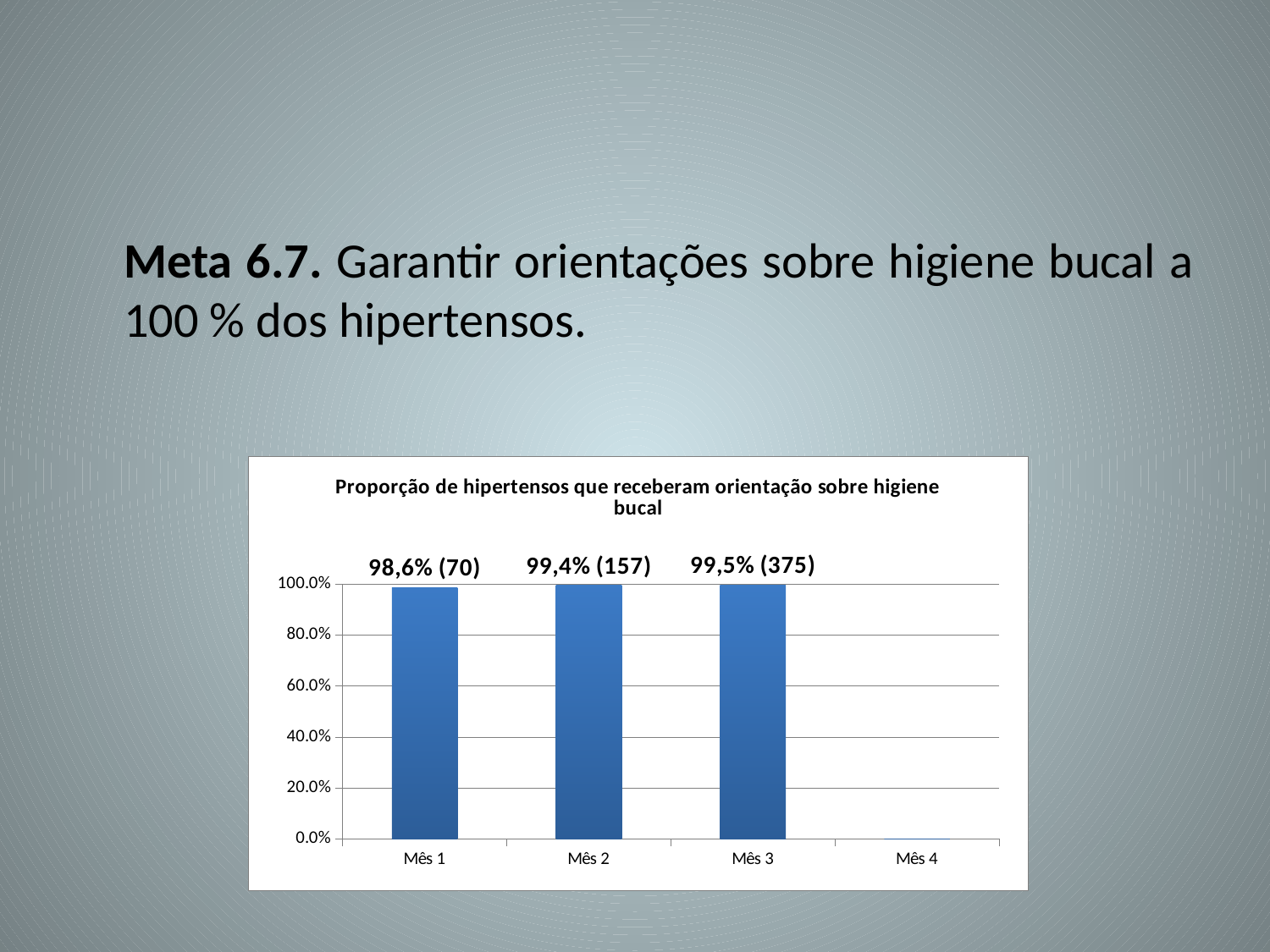
What is the difference between the number in parentheses for Mês 3 and for Mês 1? 305 Is the value for Mês 1 greater or less than 80.0%? greater What is the value shown for Mês 1? 98,6% (70) What is the value shown for Mês 2? 99,4% (157) What is the value shown for Mês 3? 99,5% (375) What kind of chart is shown? bar chart How many month categories are shown on the x axis? 4 Which is larger, the value for Mês 1 or the value for Mês 2? Mês 2 Do the values rise or fall from Mês 1 to Mês 3? rise What number in parentheses is shown for Mês 2? 157 Which month has the highest proportion according to the data labels? Mês 3